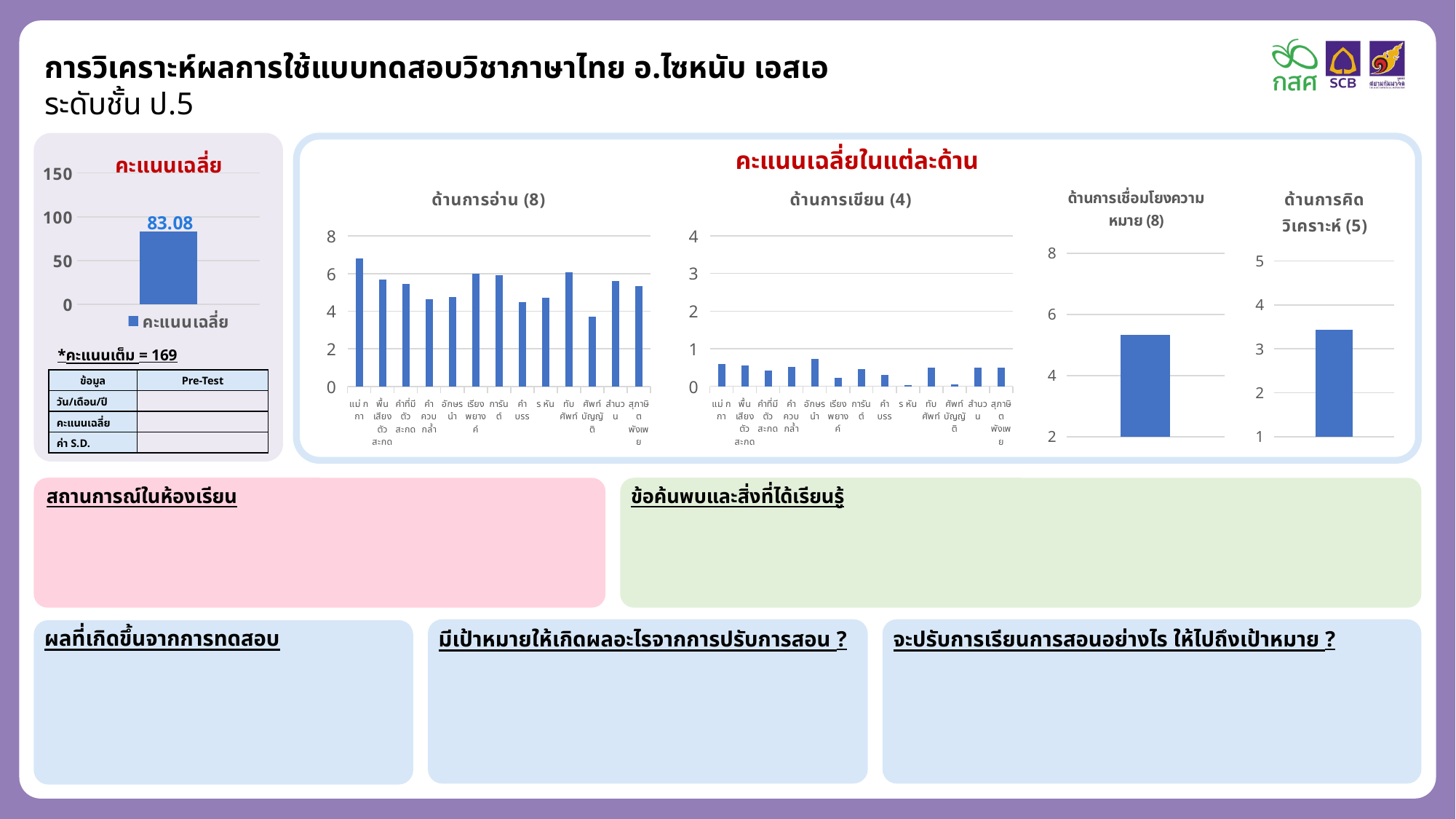
What kind of chart is the chart titled ด้านการอ่าน (8)? bar chart In the chart titled ด้านการเขียน (4), which category has the highest value? อักษรนำ In the chart titled ด้านการอ่าน (8), how many categories are plotted? 13 In the chart titled ด้านการอ่าน (8), which category has the lowest value? ศัพท์บัญญัติ In the chart titled คะแนนเฉลี่ย, what is the legend entry shown below the bar? คะแนนเฉลี่ย In the chart titled ด้านการเขียน (4), is the value for อักษรนำ greater or less than 1? less In the chart titled คะแนนเฉลี่ย, what is the value shown on the bar? 83.08 In the chart titled ด้านการเชื่อมโยงความหมาย (8), is the value of the bar greater or less than 4? greater In the chart titled ด้านการอ่าน (8), which category has the highest value? แม่ ก กา In the chart titled ด้านการคิดวิเคราะห์ (5), is the value of the bar greater or less than 3? greater